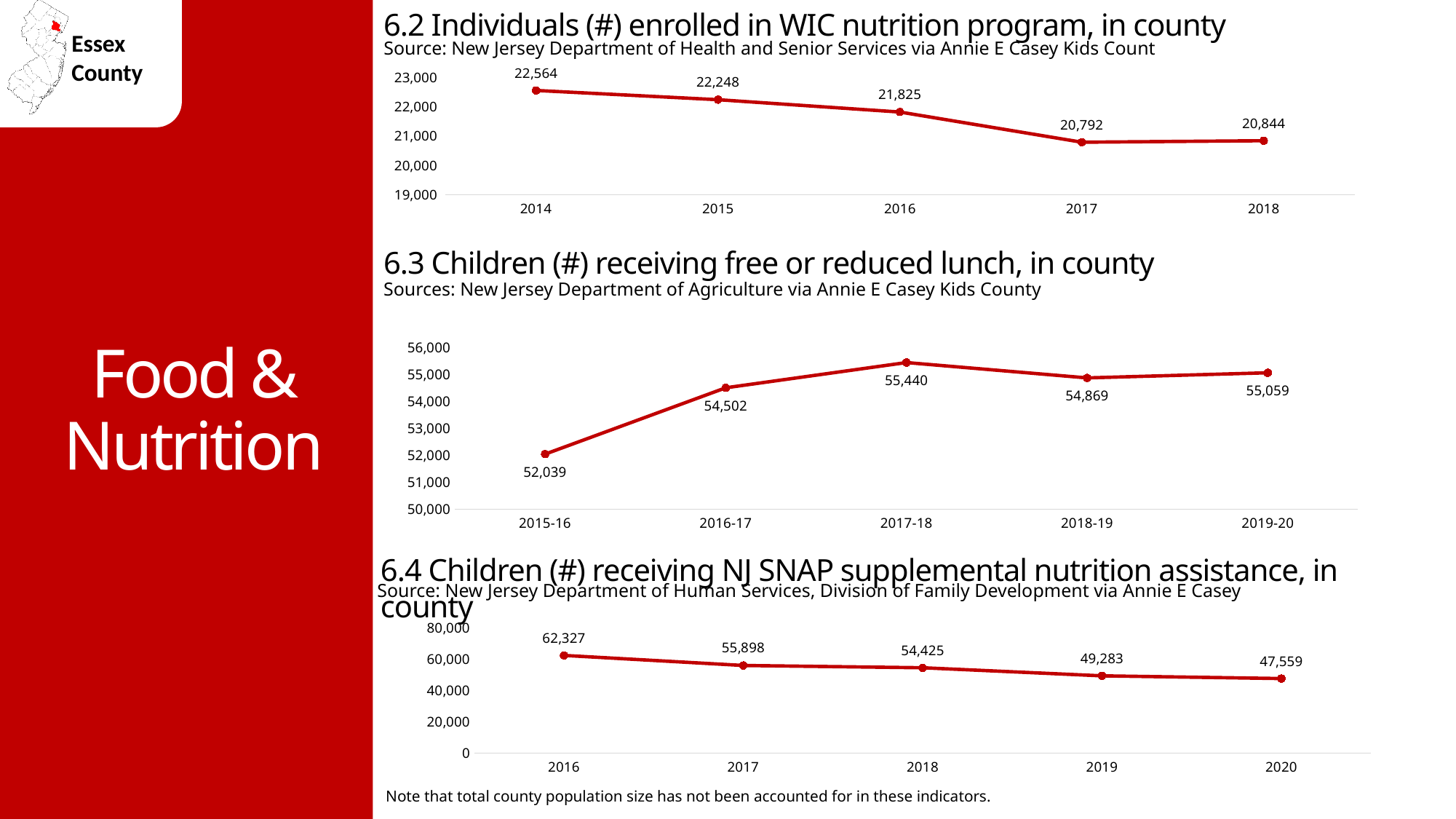
In the chart '6.2 Individuals (#) enrolled in WIC nutrition program, in county', how many years are plotted? 5 In the chart '6.4 Children (#) receiving NJ SNAP supplemental nutrition assistance, in county', which year has the highest value? 2016 In the chart '6.3 Children (#) receiving free or reduced lunch, in county', is the value for 2016-17 larger or smaller than the value for 2018-19? smaller In the chart '6.3 Children (#) receiving free or reduced lunch, in county', which school year has the lowest value? 2015-16 In the chart '6.4 Children (#) receiving NJ SNAP supplemental nutrition assistance, in county', what is the value for 2020? 47,559 In the chart '6.3 Children (#) receiving free or reduced lunch, in county', what is the value for 2017-18? 55,440 In the chart '6.2 Individuals (#) enrolled in WIC nutrition program, in county', which year has the lowest value? 2017 In the chart '6.3 Children (#) receiving free or reduced lunch, in county', what is the difference between the 2016-17 and 2015-16 values? 2,463 In the chart '6.4 Children (#) receiving NJ SNAP supplemental nutrition assistance, in county', do the values rise or fall from 2016 to 2020? fall In the chart '6.2 Individuals (#) enrolled in WIC nutrition program, in county', what is the difference between the 2014 and 2018 values? 1,720 What kind of chart is '6.4 Children (#) receiving NJ SNAP supplemental nutrition assistance, in county'? line chart In the chart '6.2 Individuals (#) enrolled in WIC nutrition program, in county', what is the value for 2014? 22,564